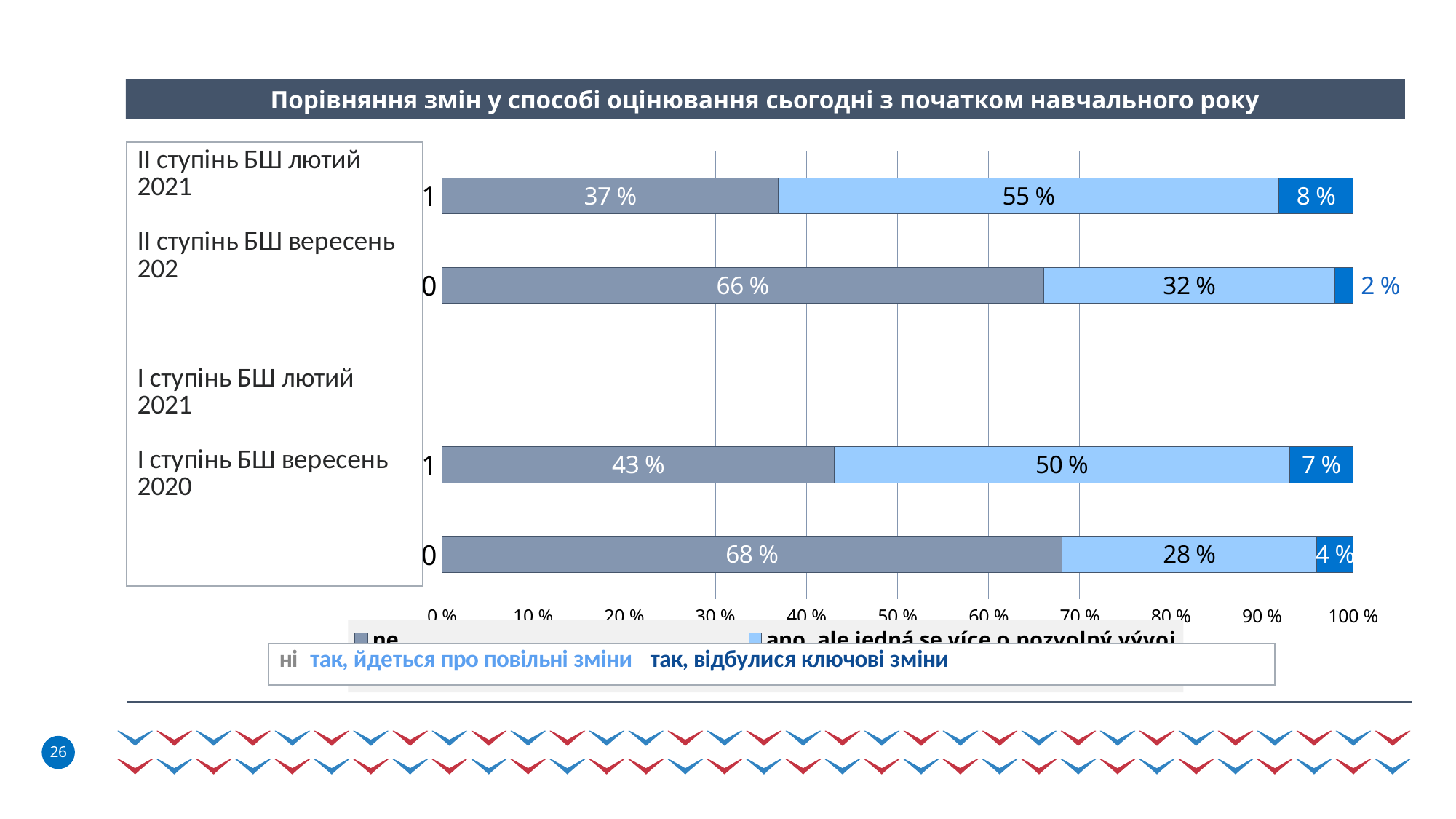
What is the value of the 'так, відбулися ключові зміни' segment in the bottom bar (І ступінь БШ вересень 2020)? 4 % How many series does the chart's legend list? 3 What is the title of the chart? Порівняння змін у способі оцінювання сьогодні з початком навчального року What is the total of the three segments in the top bar? 100 % Which bar has the largest 'ні' segment? The bottom bar (І ступінь БШ вересень 2020), 68 % What is the value of the 'так, йдеться про повільні зміни' segment in the second bar from the top (ІІ ступінь БШ вересень 2020)? 32 % Which bar has the smallest 'так, відбулися ключові зміни' segment? The second bar from the top (ІІ ступінь БШ вересень 2020), 2 % What kind of chart is shown on the slide? Stacked bar chart What is the value of the 'ні' segment in the top bar (ІІ ступінь БШ лютий 2021)? 37 % In the top bar, what is the difference between the 'так, йдеться про повільні зміни' segment and the 'ні' segment? 18 percentage points In the third bar from the top (І ступінь БШ лютий 2021), which is larger: the 'ні' segment or the 'так, йдеться про повільні зміни' segment? так, йдеться про повільні зміни (50 %) How many bars are plotted in the chart? 4